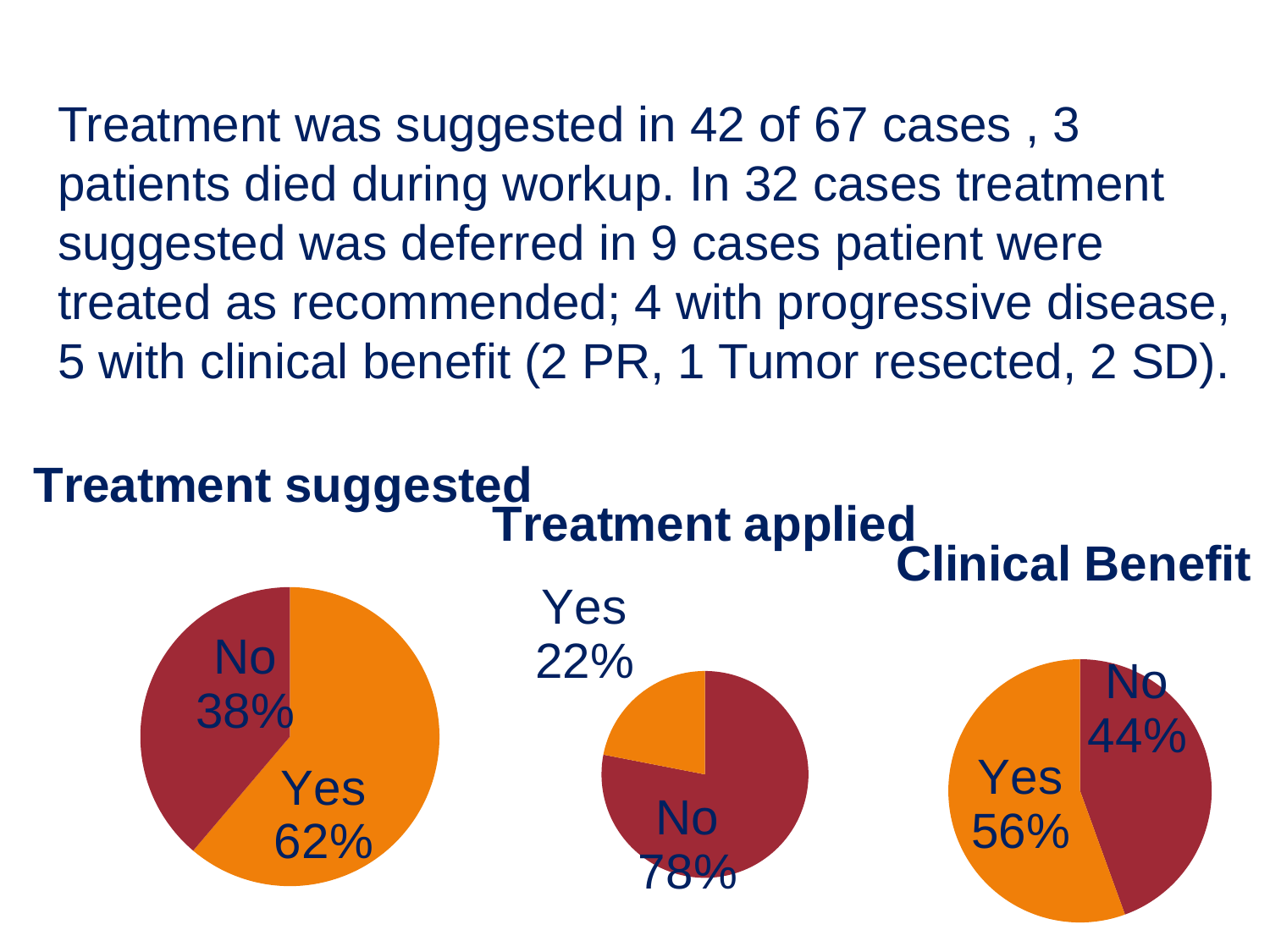
How many slices does the 'Clinical Benefit' pie chart have? 2 In the 'Treatment applied' pie chart, which slice is larger, Yes or No? No In the 'Treatment applied' pie chart, what share is labelled Yes? 22% In the 'Treatment applied' pie chart, what share is labelled No? 78% In the 'Treatment suggested' pie chart, what share is labelled Yes? 62% In the 'Treatment suggested' pie chart, what is the difference between the Yes and No shares? 24% How many pie charts are shown on the slide? 3 In the 'Clinical Benefit' pie chart, which slice is the largest? Yes What kind of chart is the 'Treatment applied' chart? Pie chart